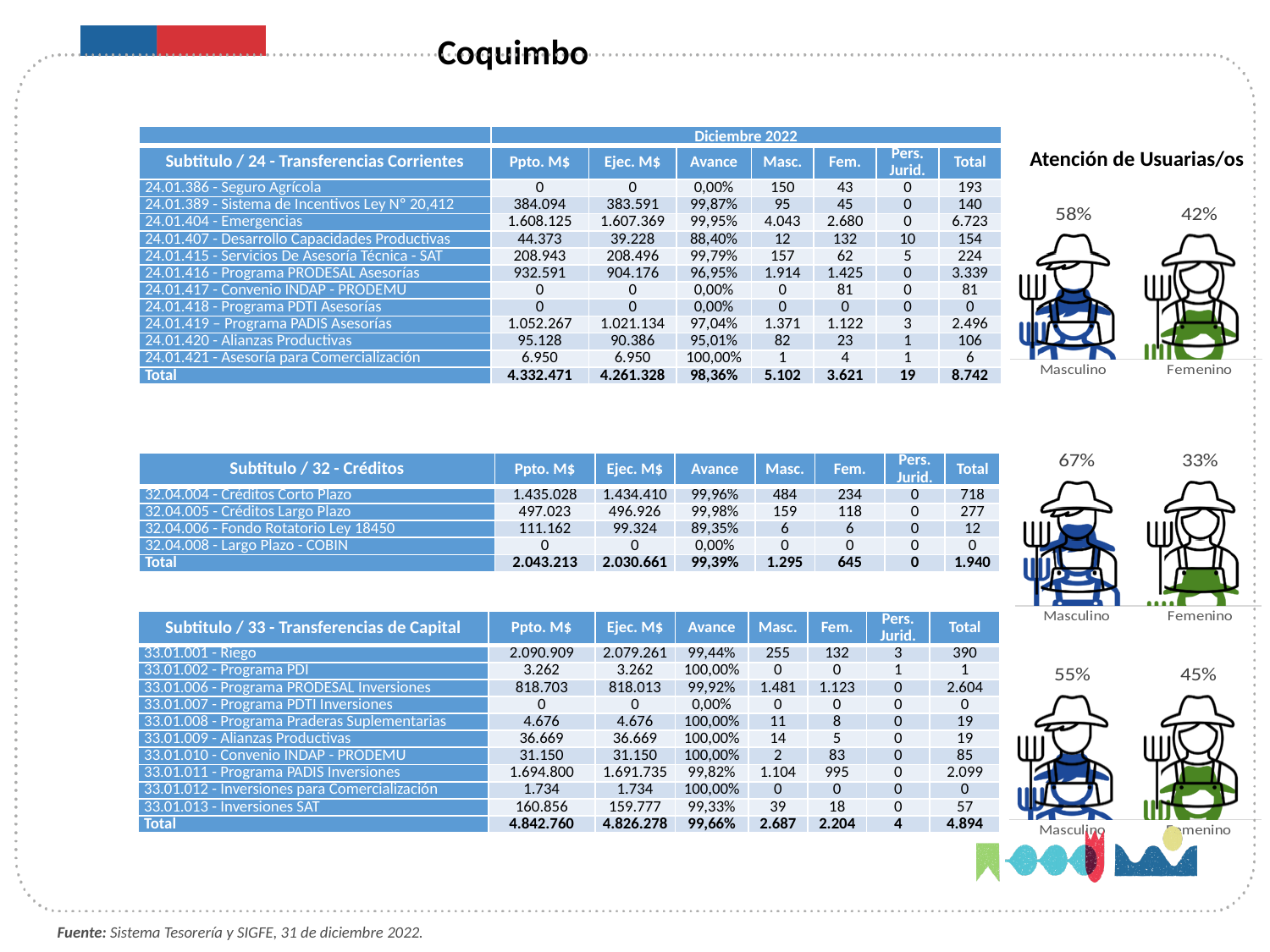
In the bottom-right pictograph (next to the Subtítulo 33 - Transferencias de Capital table), what percentage is shown for Masculino? 55% In the middle-right pictograph (next to the Subtítulo 32 - Créditos table), which group has the smaller share? Femenino In the middle-right pictograph (next to the Subtítulo 32 - Créditos table), what percentage is shown for Masculino? 67% In the top-right 'Atención de Usuarias/os' pictograph, what is the difference between the Masculino and Femenino percentages? 16 percentage points In the bottom-right pictograph (next to the Subtítulo 33 - Transferencias de Capital table), what percentage is shown for Femenino? 45% What is the title shown above the top-right pictograph? Atención de Usuarias/os In the middle-right pictograph (next to the Subtítulo 32 - Créditos table), what is the difference between the Masculino and Femenino percentages? 34 percentage points In the top-right 'Atención de Usuarias/os' pictograph, which group has the larger share, Masculino or Femenino? Masculino In the top-right 'Atención de Usuarias/os' pictograph (next to the Subtítulo 24 table), what percentage is shown for Femenino? 42% In the top-right 'Atención de Usuarias/os' pictograph (next to the Subtítulo 24 table), what percentage is shown for Masculino? 58% How many categories does each of the pictographs on the right side of the slide show? 2 In the middle-right pictograph (next to the Subtítulo 32 - Créditos table), what percentage is shown for Femenino? 33%